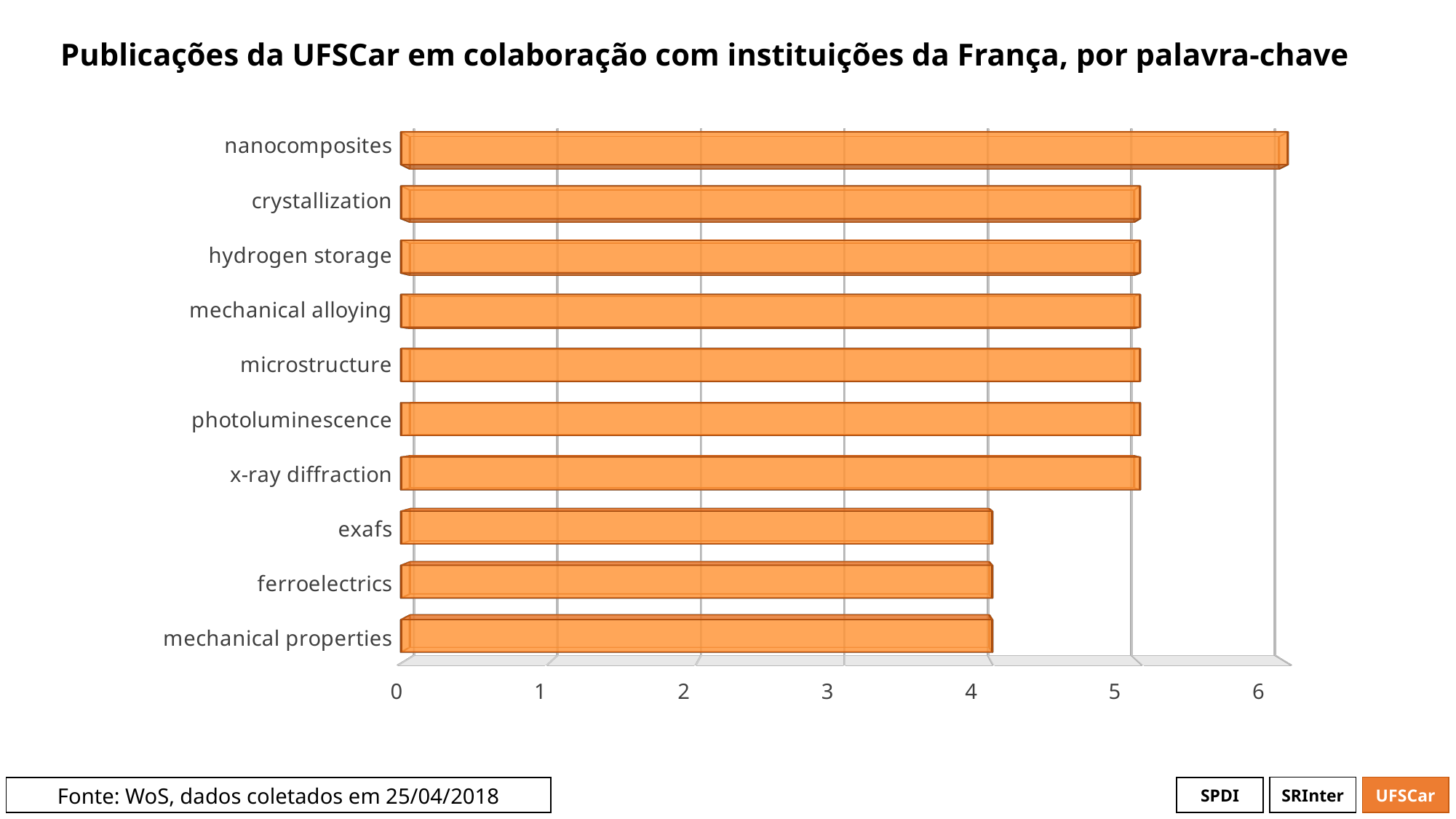
Is the value for nanocomposites greater or less than 5? greater Is the value for crystallization greater or less than 4? greater What kind of chart is shown on the slide? bar chart What is the source of the data cited on the slide? WoS, dados coletados em 25/04/2018 Is the value for ferroelectrics greater or less than 3? greater Which has more publications, crystallization or ferroelectrics? crystallization Which has more publications, nanocomposites or exafs? nanocomposites What is the title of the chart? Publicações da UFSCar em colaboração com instituições da França, por palavra-chave How many keyword categories are plotted in the chart? 10 Which keyword has the highest number of publications? nanocomposites